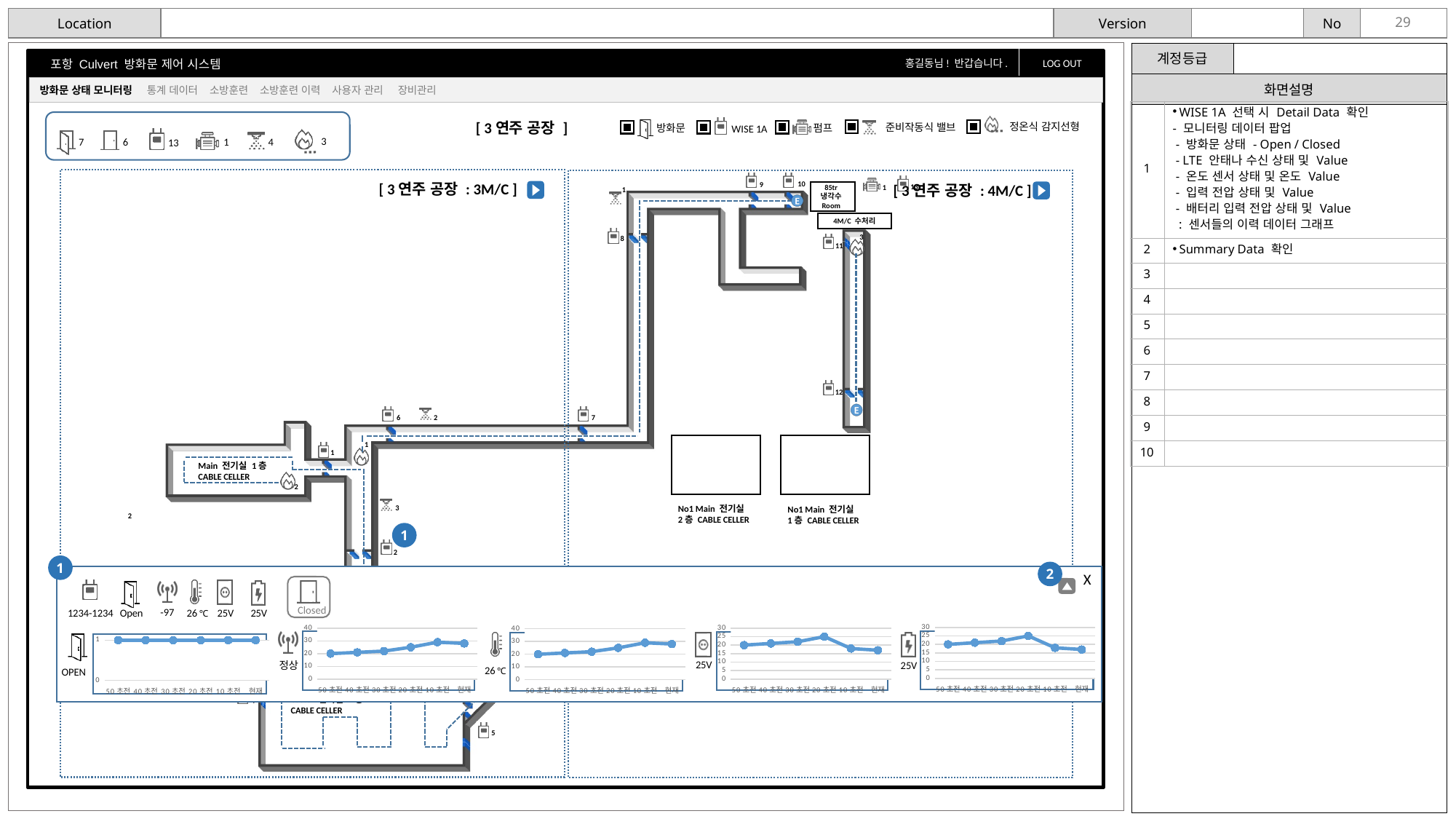
In the second chart from the left (next to the 정상 label), do the values rise or fall from 50초전 to 현재? rise How many data points are plotted in the second chart from the left (next to the 정상 label) in the detail panel? 6 In the fourth chart from the left (next to the first 25V label), at which x-axis label is the value highest? 20초전 In the fourth chart from the left (next to the first 25V label), do the values rise or fall from 20초전 to 현재? fall How many small charts are shown in the detail panel at the bottom of the slide? 5 In the rightmost chart (next to the second 25V label), is the value at 현재 greater or less than 25? less In the second chart from the left (next to the 정상 label), at which x-axis label is the value highest? 10초전 In the leftmost chart (next to the OPEN label), what value does the line sit at for 현재? 1 In the second chart from the left (next to the 정상 label), is the value at 현재 greater or less than 20? greater In the third chart from the left (next to the 26℃ label), is the value at 10초전 greater or less than 20? greater What is the highest y-axis tick shown on the second chart from the left (next to the 정상 label)? 40 What kind of chart is the leftmost chart (next to the OPEN label) in the detail panel at the bottom of the slide? line chart